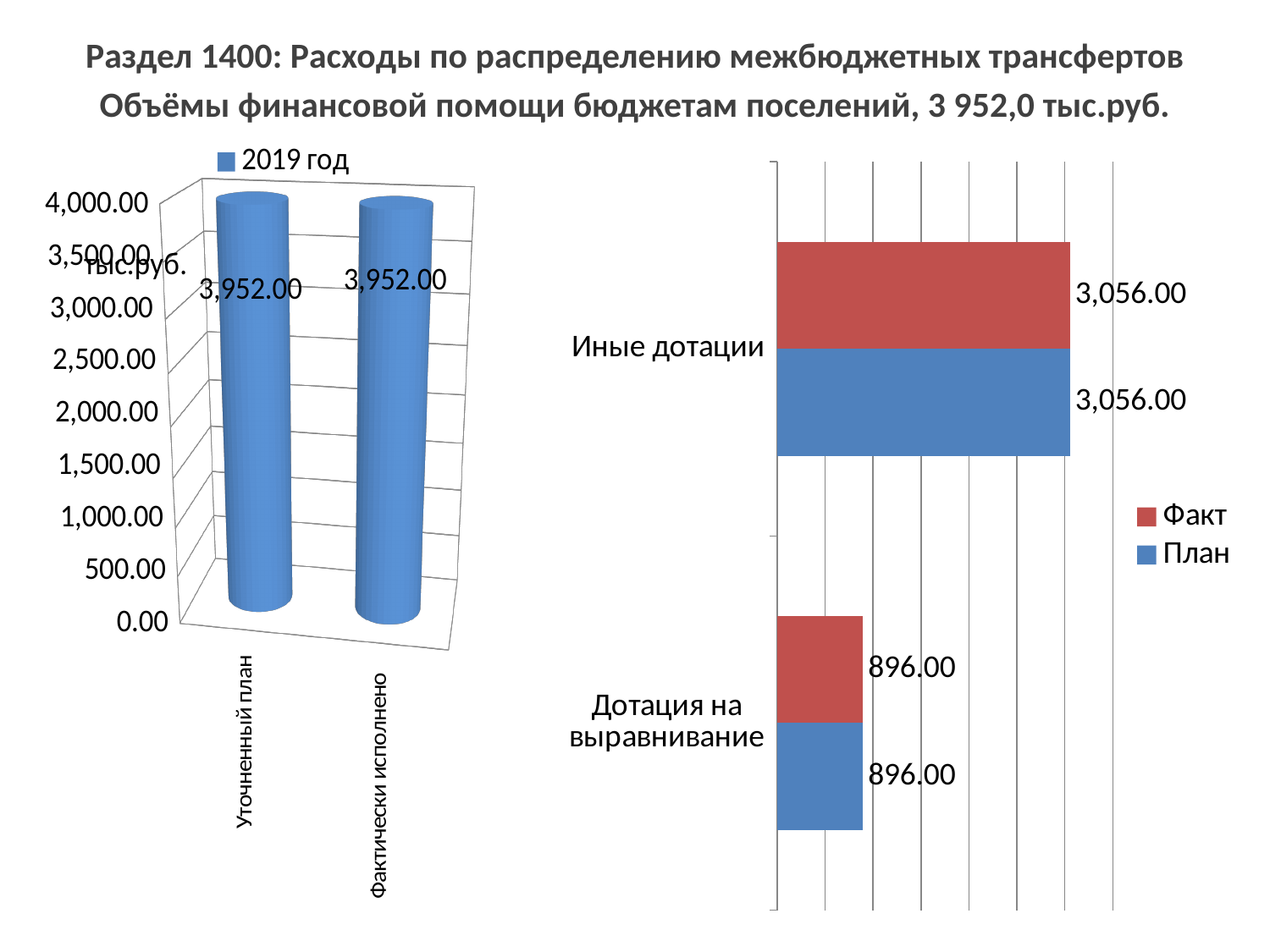
On the right chart, how many series does the legend list? 2 What kind of chart is the right chart? Bar chart On the right chart, what is the difference between the План values for Иные дотации and Дотация на выравнивание? 2,160.00 On the right chart, which category has the highest Факт value? Иные дотации On the right chart, which category has the lowest План value? Дотация на выравнивание On the right chart, what is the План value for Иные дотации? 3,056.00 On the left chart, what is the value for Уточненный план? 3,952.00 On the left chart, what is the difference between Уточненный план and Фактически исполнено? 0.00 On the left chart, what series does the legend list? 2019 год On the left chart, how many categories are shown on the x axis? 2 On the left chart, what is the value for Фактически исполнено? 3,952.00 On the right chart, what is the Факт value for Дотация на выравнивание? 896.00